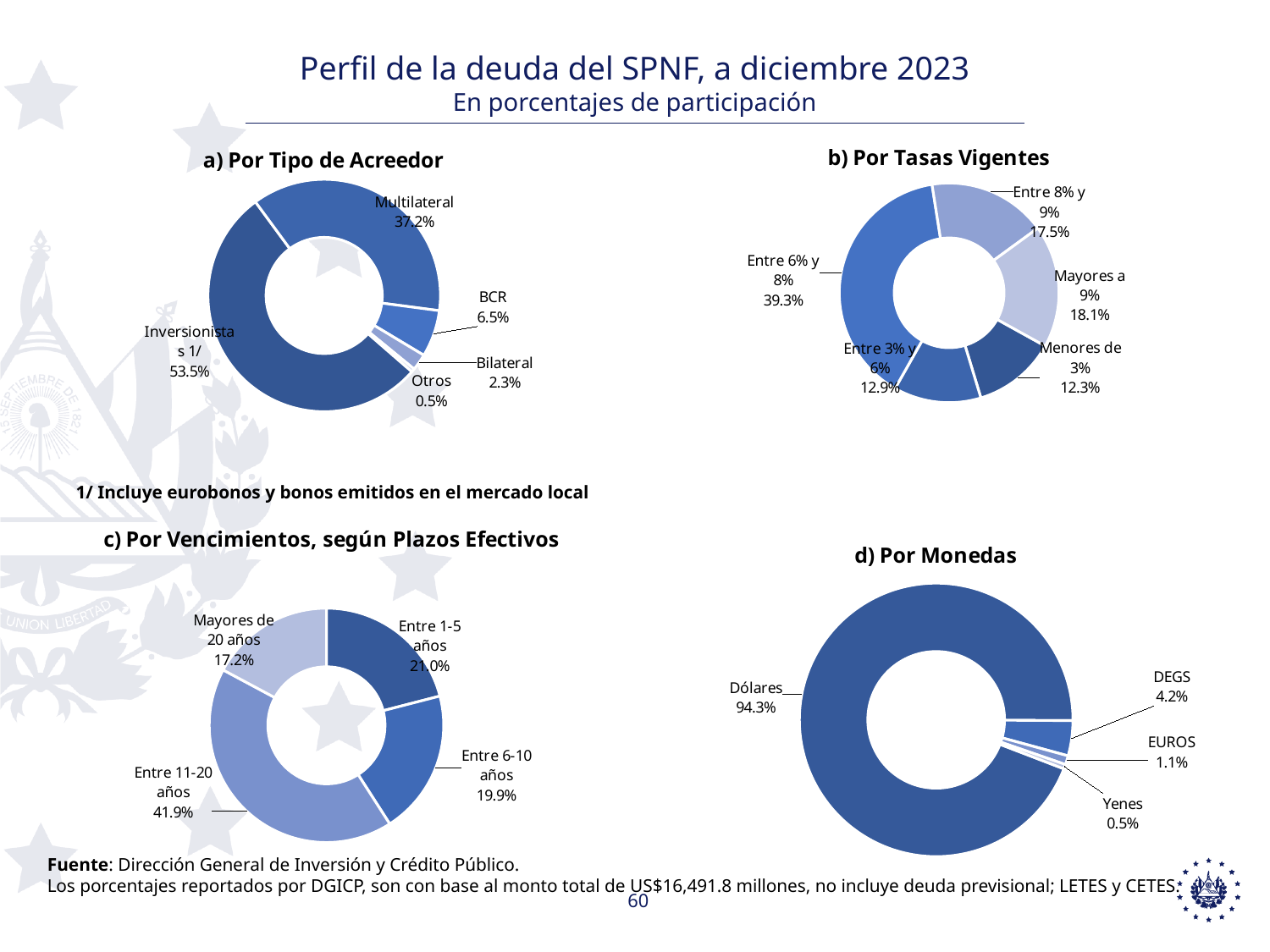
In the chart 'a) Por Tipo de Acreedor', which category has the smallest share? Otros In the chart 'c) Por Vencimientos, según Plazos Efectivos', which category has the smallest share? Mayores de 20 años In the chart 'a) Por Tipo de Acreedor', which category has the largest share? Inversionistas 1/ In the chart 'd) Por Monedas', what is the difference between the shares of Dólares and DEGS? 90.1% What kind of chart is 'd) Por Monedas'? Pie (doughnut) chart In the chart 'd) Por Monedas', what share is labelled for DEGS? 4.2% In the chart 'a) Por Tipo de Acreedor', what share is labelled for Multilateral? 37.2% In the chart 'b) Por Tasas Vigentes', how many categories are shown? 5 In the chart 'c) Por Vencimientos, según Plazos Efectivos', what share is labelled for 'Entre 11-20 años'? 41.9% In the chart 'b) Por Tasas Vigentes', which is larger, 'Mayores a 9%' or 'Entre 8% y 9%'? Mayores a 9% In the chart 'b) Por Tasas Vigentes', what share is labelled for 'Entre 6% y 8%'? 39.3% In the chart 'a) Por Tipo de Acreedor', what is the difference between the shares of BCR and Bilateral? 4.2%